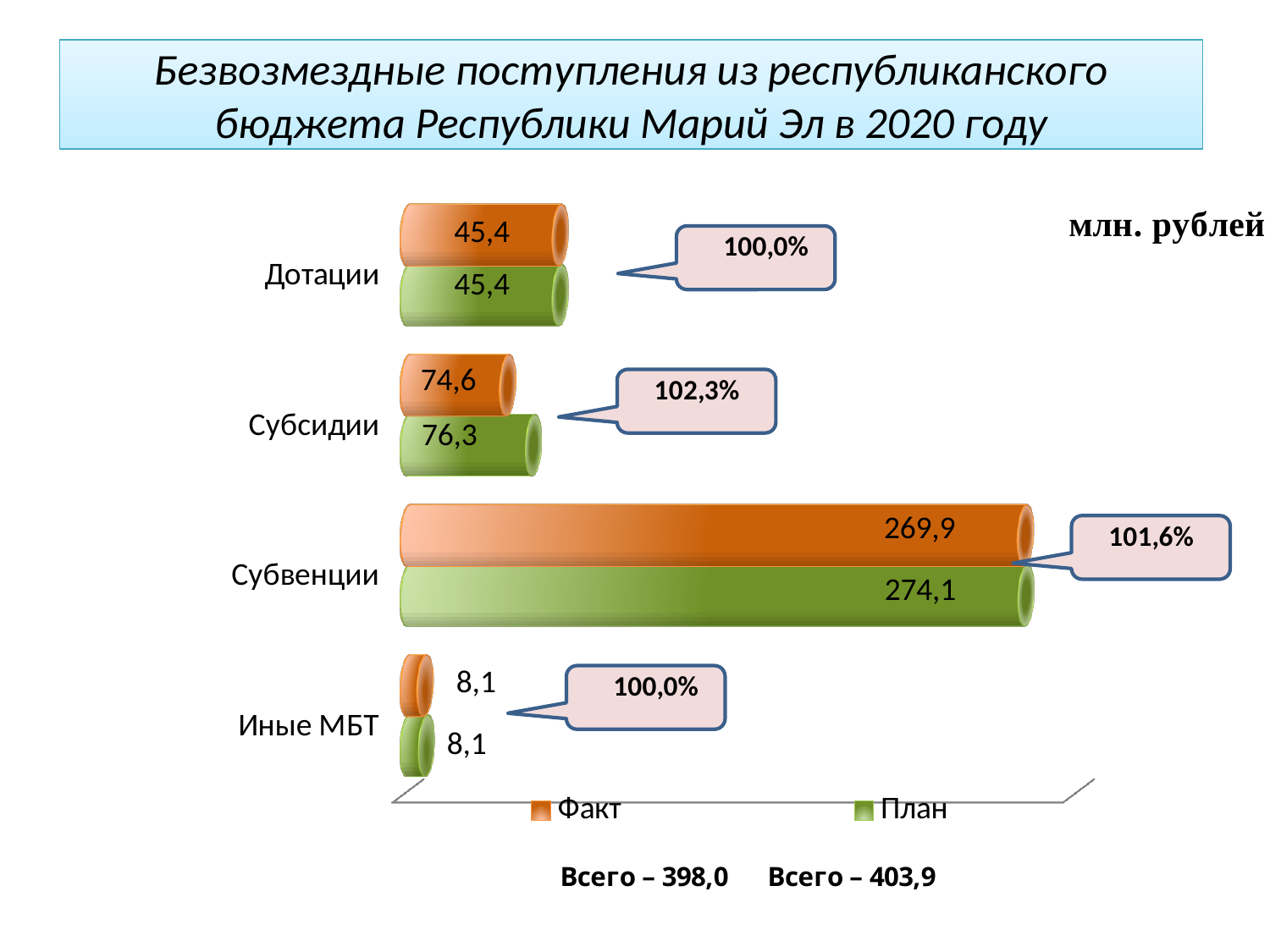
What percentage is shown in the callout next to Субсидии? 102,3% How many categories are shown on the chart? 4 Which is larger for Субсидии, the Факт value or the План value? План How many series does the legend list? 2 Which category has the lowest Факт value? Иные МБТ What total (Всего) is given for the Факт series below the chart? 398,0 What is the difference between the План and Факт values for Субвенции? 4,2 Which category has the highest План value? Субвенции What kind of chart is shown on the slide? Bar chart What is the План value for Субсидии? 76,3 What is the Факт value for Субвенции? 269,9 What is the Факт value for Иные МБТ? 8,1